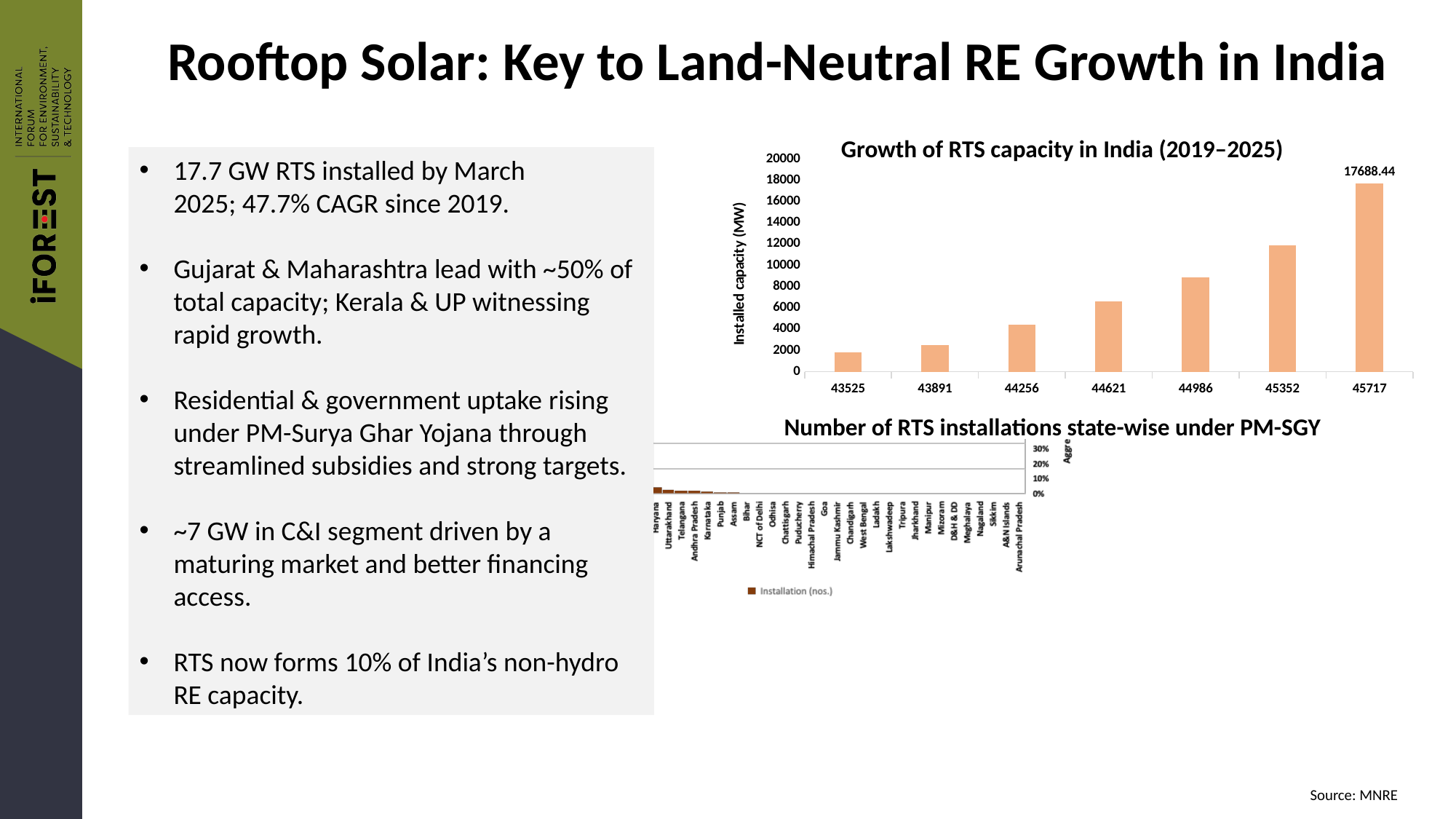
What legend entry is shown in the chart 'Number of RTS installations state-wise under PM-SGY'? Installation (nos.) In the chart 'Growth of RTS capacity in India (2019–2025)', is the value for 44621 greater or less than 8000? less In the chart 'Growth of RTS capacity in India (2019–2025)', which x-axis category has the highest installed capacity? 45717 What kind of chart is 'Growth of RTS capacity in India (2019–2025)'? Bar chart In the chart 'Growth of RTS capacity in India (2019–2025)', is the value for 44986 greater or less than 8000? greater In the chart 'Growth of RTS capacity in India (2019–2025)', what is the installed capacity value labelled on the bar for 45717? 17688.44 What is the y-axis title of the chart 'Growth of RTS capacity in India (2019–2025)'? Installed capacity (MW) In the chart 'Growth of RTS capacity in India (2019–2025)', which x-axis category has the lowest installed capacity? 43525 How many bars are plotted in the chart 'Growth of RTS capacity in India (2019–2025)'? 7 In the chart 'Growth of RTS capacity in India (2019–2025)', is the value for 45352 greater or less than 10000? greater In the chart 'Growth of RTS capacity in India (2019–2025)', which has the larger installed capacity, 45352 or 44986? 45352 In the chart 'Growth of RTS capacity in India (2019–2025)', do the values rise or fall from left to right along the x axis? Rise